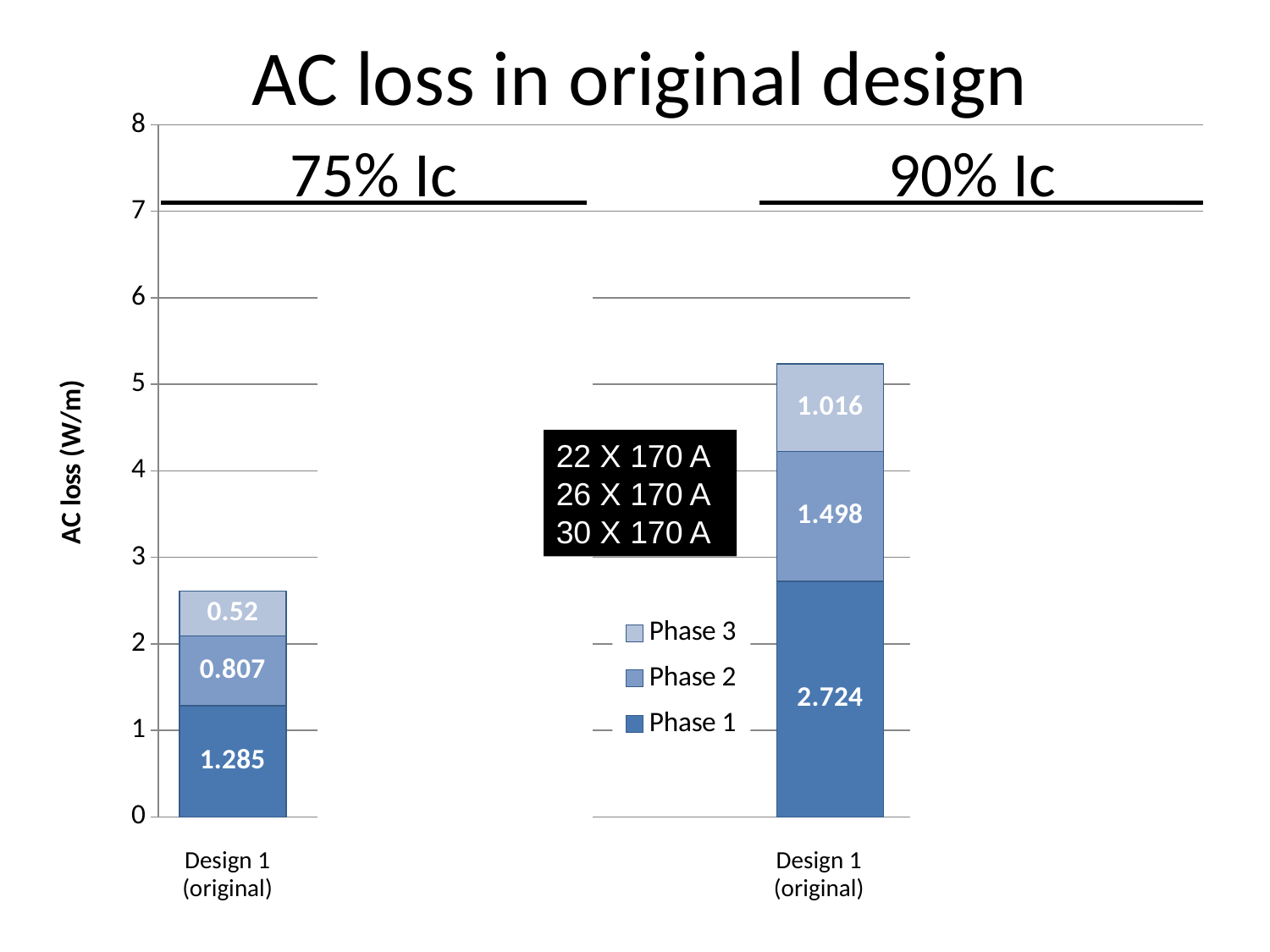
Which is larger: the Phase 2 value in the 75% Ic chart or the Phase 3 value in the 90% Ic chart? Phase 3 in the 90% Ic chart In the 90% Ic chart, what is the Phase 1 value for Design 1 (original)? 2.724 In the 90% Ic chart, which phase contributes the largest AC loss for Design 1 (original)? Phase 1 What is the difference between the Phase 1 value in the 90% Ic chart and the Phase 1 value in the 75% Ic chart? 1.439 What is the total AC loss of the stacked bar for Design 1 (original) in the 90% Ic chart? 5.238 How many series does the legend list? 3 In the 75% Ic chart, what is the Phase 3 value for Design 1 (original)? 0.52 What is the total AC loss of the stacked bar for Design 1 (original) in the 75% Ic chart? 2.612 In the 75% Ic chart, what is the Phase 1 value for Design 1 (original)? 1.285 In the 75% Ic chart, which phase contributes the smallest AC loss for Design 1 (original)? Phase 3 In the 90% Ic chart, what is the Phase 2 value for Design 1 (original)? 1.498 What kind of chart is used to show the AC loss values? Stacked bar chart